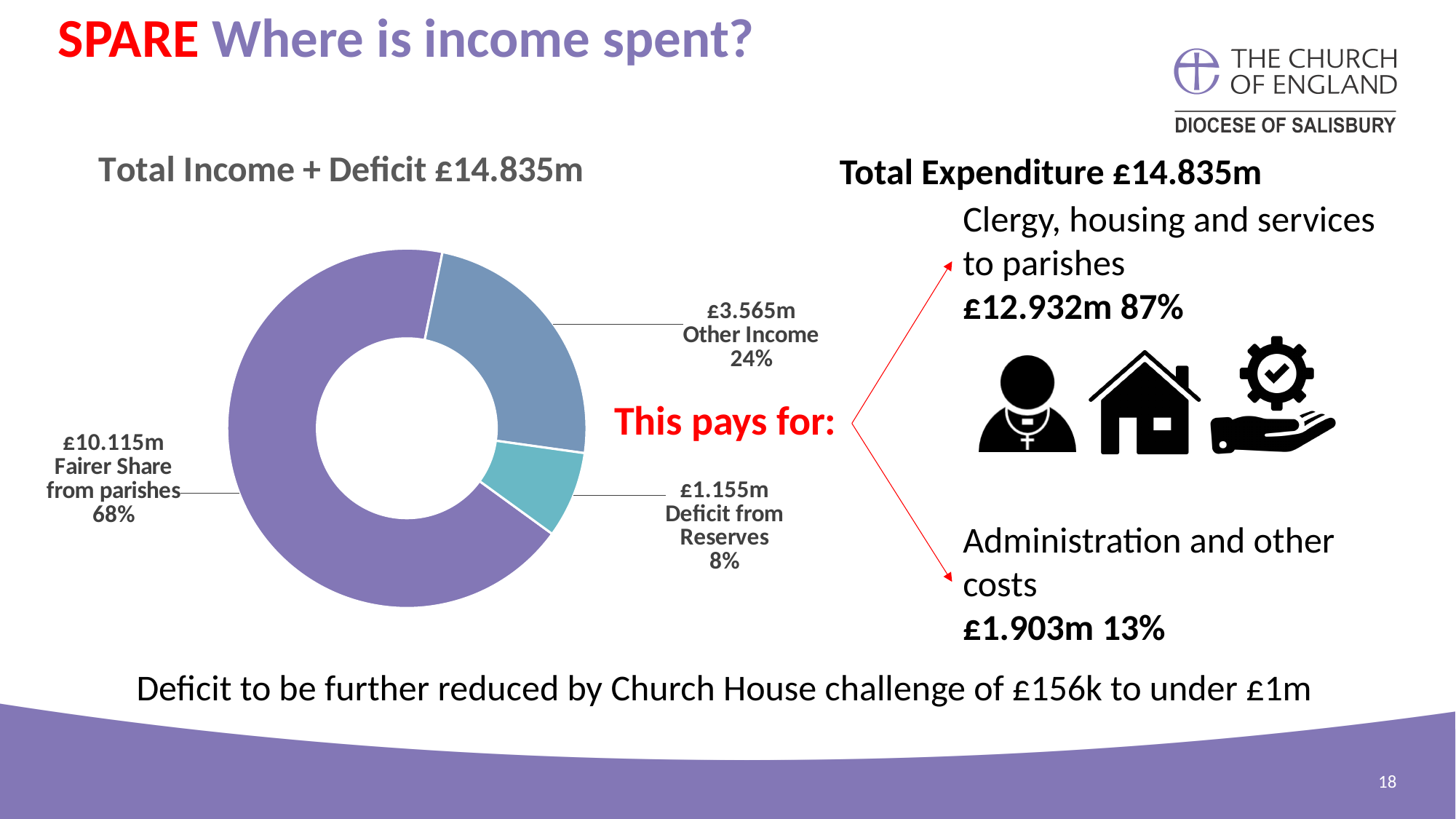
What is the difference between Fairer Share from parishes and Other Income? £6.550m What is the value for Deficit from Reserves? £1.155m What kind of chart is shown on the slide? Doughnut chart Which slice is the largest? Fairer Share from parishes How many slices does the chart have? 3 What is the title of the chart? Total Income + Deficit £14.835m Which slice is the smallest? Deficit from Reserves What is the value for Other Income? £3.565m What share of the chart is Fairer Share from parishes? 68% Which is larger, Other Income or Deficit from Reserves? Other Income What is the value for Fairer Share from parishes? £10.115m What share of the chart is Other Income? 24%